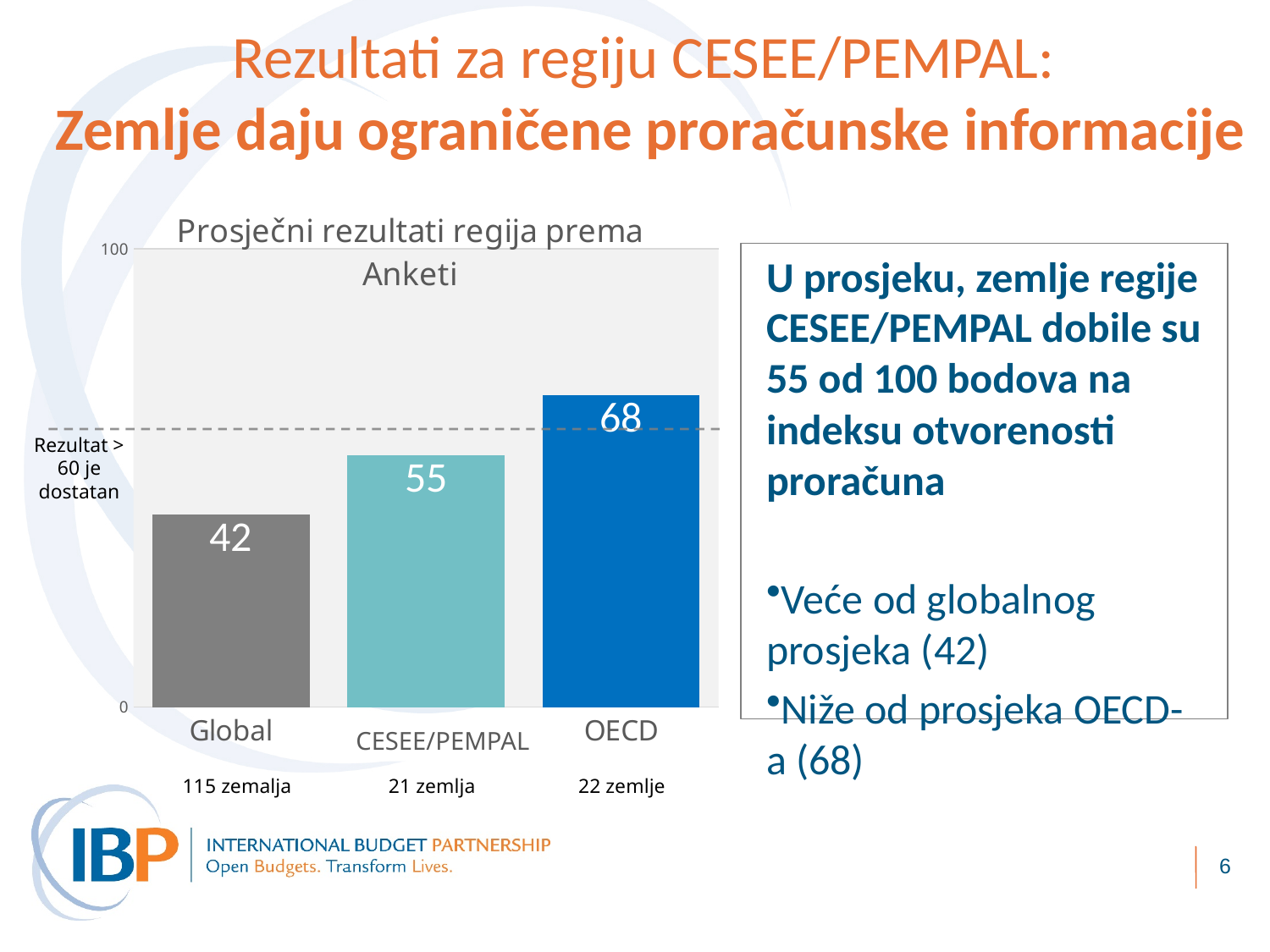
What kind of chart is shown on the slide? Bar chart Which category has the highest value? OECD How many categories are shown in the chart? 3 What is the value for Global? 42 What is the value for OECD? 68 What is the value for CESEE/PEMPAL? 55 What is the title of the chart? Prosječni rezultati regija prema Anketi What is the difference between the CESEE/PEMPAL value and the Global value? 13 Which category has the lowest value? Global Do the values rise or fall from left to right across the categories? Rise What is the difference between the OECD value and the CESEE/PEMPAL value? 13 Which is larger, the value for Global or the value for CESEE/PEMPAL? CESEE/PEMPAL